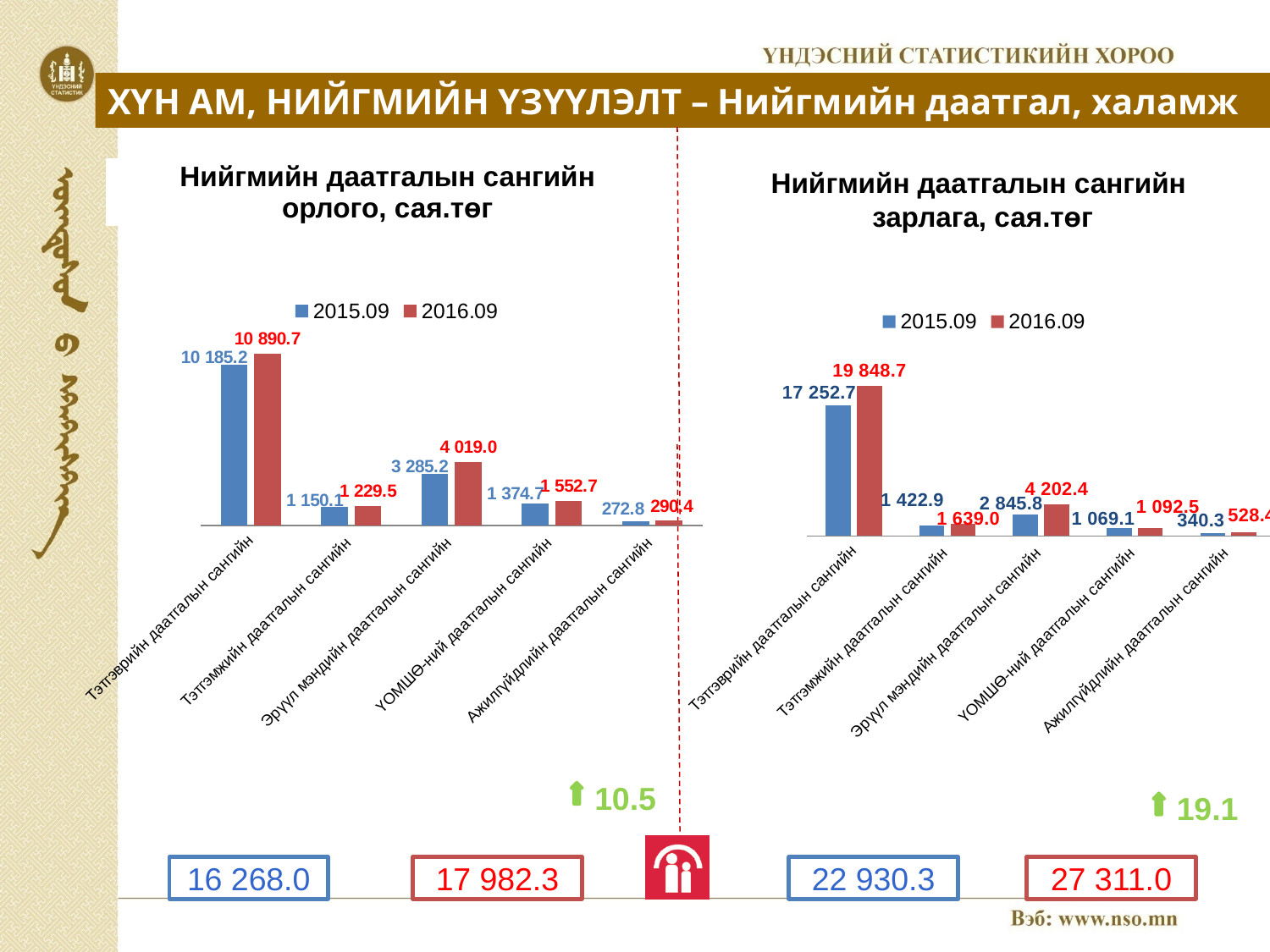
How many series does the legend list in the chart titled "Нийгмийн даатгалын сангийн зарлага, сая.төг"? 2 In the chart titled "Нийгмийн даатгалын сангийн орлого, сая.төг", which category has the lowest 2016.09 value? Ажилгүйдлийн даатгалын сангийн In the chart titled "Нийгмийн даатгалын сангийн орлого, сая.төг", what is the 2015.09 value for Эрүүл мэндийн даатгалын сангийн? 3 285.2 In the chart titled "Нийгмийн даатгалын сангийн зарлага, сая.төг", what is the 2016.09 value for Тэтгэврийн даатгалын сангийн? 19 848.7 In the chart titled "Нийгмийн даатгалын сангийн орлого, сая.төг", what is the 2016.09 value for Тэтгэврийн даатгалын сангийн? 10 890.7 In the chart titled "Нийгмийн даатгалын сангийн орлого, сая.төг", what is the difference between the 2016.09 and 2015.09 values for Эрүүл мэндийн даатгалын сангийн? 733.8 How many categories are shown on the x axis of the chart titled "Нийгмийн даатгалын сангийн орлого, сая.төг"? 5 In the chart titled "Нийгмийн даатгалын сангийн зарлага, сая.төг", which category has the highest 2015.09 value? Тэтгэврийн даатгалын сангийн In the chart titled "Нийгмийн даатгалын сангийн зарлага, сая.төг", which is larger for Эрүүл мэндийн даатгалын сангийн: the 2015.09 value or the 2016.09 value? 2016.09 In the chart titled "Нийгмийн даатгалын сангийн зарлага, сая.төг", what is the difference between the 2016.09 and 2015.09 values for Тэтгэврийн даатгалын сангийн? 2 596.0 In the chart titled "Нийгмийн даатгалын сангийн зарлага, сая.төг", what is the 2015.09 value for ҮОМШӨ-ний даатгалын сангийн? 1 069.1 What type of chart is the chart titled "Нийгмийн даатгалын сангийн орлого, сая.төг"? Bar chart